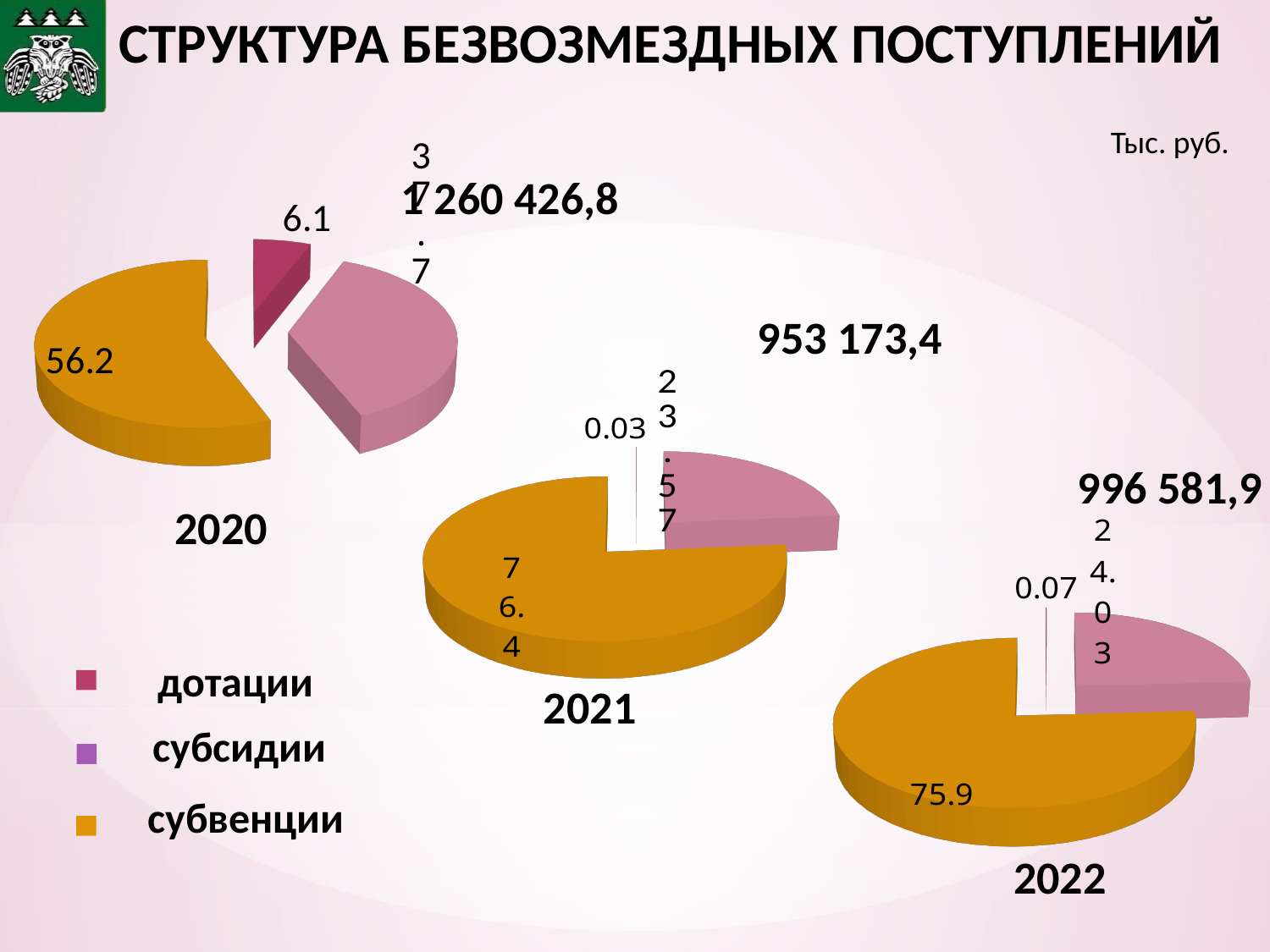
What total amount is printed above the 2021 pie chart? 953 173,4 Which slice is the largest in the 2022 pie chart? субвенции In the 2021 pie chart, what is the smallest value shown? 0.03 In the 2022 pie chart, what is the value of the orange (субвенции) slice? 75.9 In the 2021 pie chart, what is the value of the orange (субвенции) slice? 76.4 How many entries does the legend list? 3 In the 2022 pie chart, what is the smallest value shown? 0.07 Is the orange (субвенции) slice larger in the 2021 pie chart or in the 2022 pie chart? 2021 In the 2020 pie chart, what is the value of the dark pink (дотации) slice? 6.1 What kind of charts are shown on the slide? pie charts In the 2020 pie chart, what is the value of the largest (orange) slice? 56.2 How many pie charts are on the slide? 3